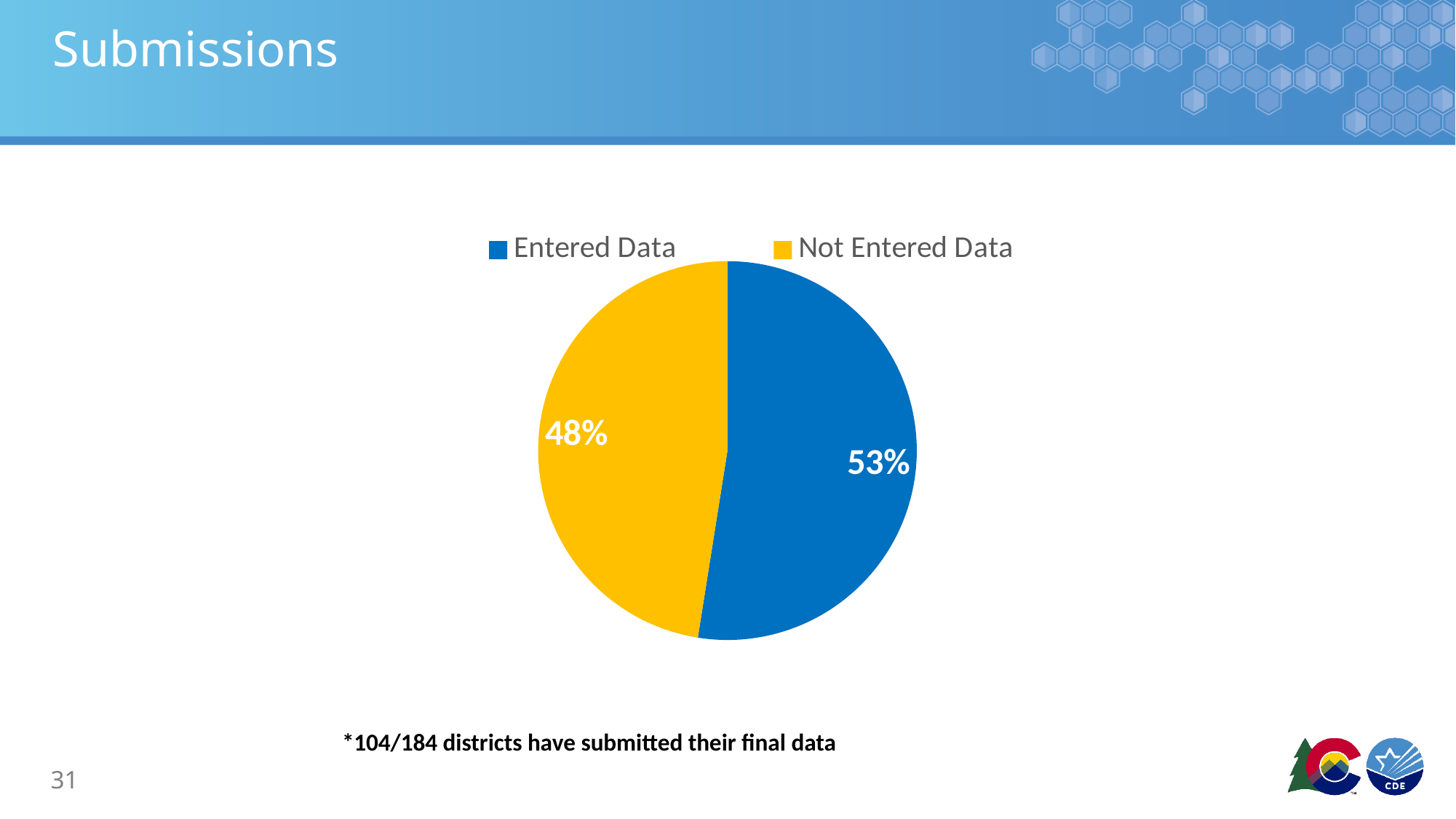
Which slice of the pie is larger, Entered Data or Not Entered Data? Entered Data What kind of chart is shown on the slide? pie chart Which category has the smallest share of the pie? Not Entered Data How many entries does the legend list? 2 How many slices does the pie chart have? 2 Is the share for Not Entered Data greater or less than 50%? less Which category has the largest share of the pie? Entered Data What colour is the Not Entered Data slice? yellow What colour is the Entered Data slice? blue What percentage of the pie is labelled for Not Entered Data? 48% What is the difference in percentage points between the Entered Data and Not Entered Data slices? 5 What percentage of the pie is labelled for Entered Data? 53%